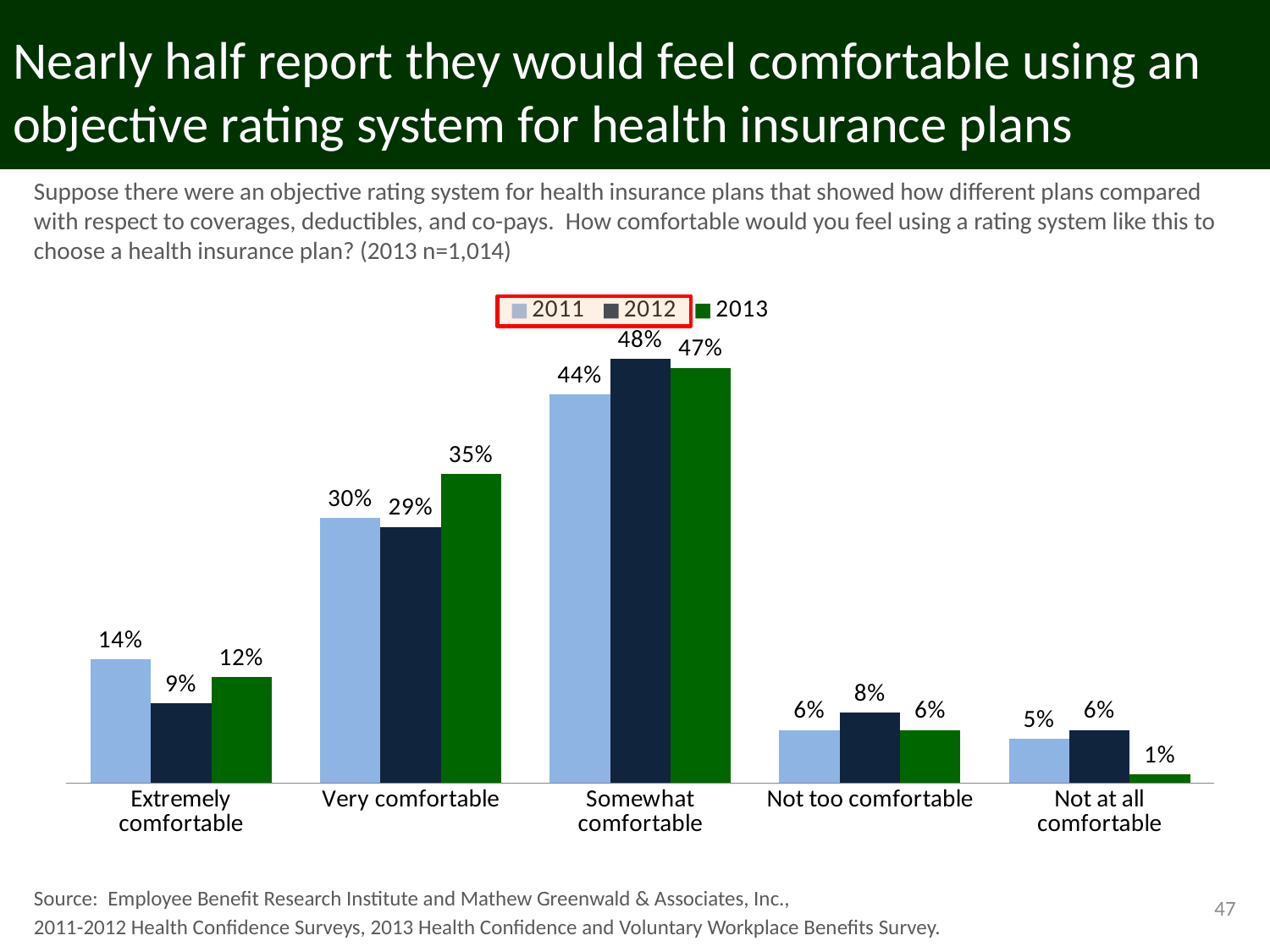
How many series does the legend list? 3 Which category has the lowest 2011 value? Not at all comfortable What kind of chart is shown on the slide? Bar chart How many response categories are shown on the x axis? 5 Which series is shown in green in the legend? 2013 What is the 2011 value for Extremely comfortable? 14% Which category has the highest 2013 value? Somewhat comfortable What is the 2012 value for Somewhat comfortable? 48% Which is larger for Extremely comfortable, the 2011 value or the 2012 value? 2011 What is the 2013 value for Not at all comfortable? 1% What is the 2013 value for Very comfortable? 35% What is the difference between the 2013 and 2011 values for Very comfortable? 5%